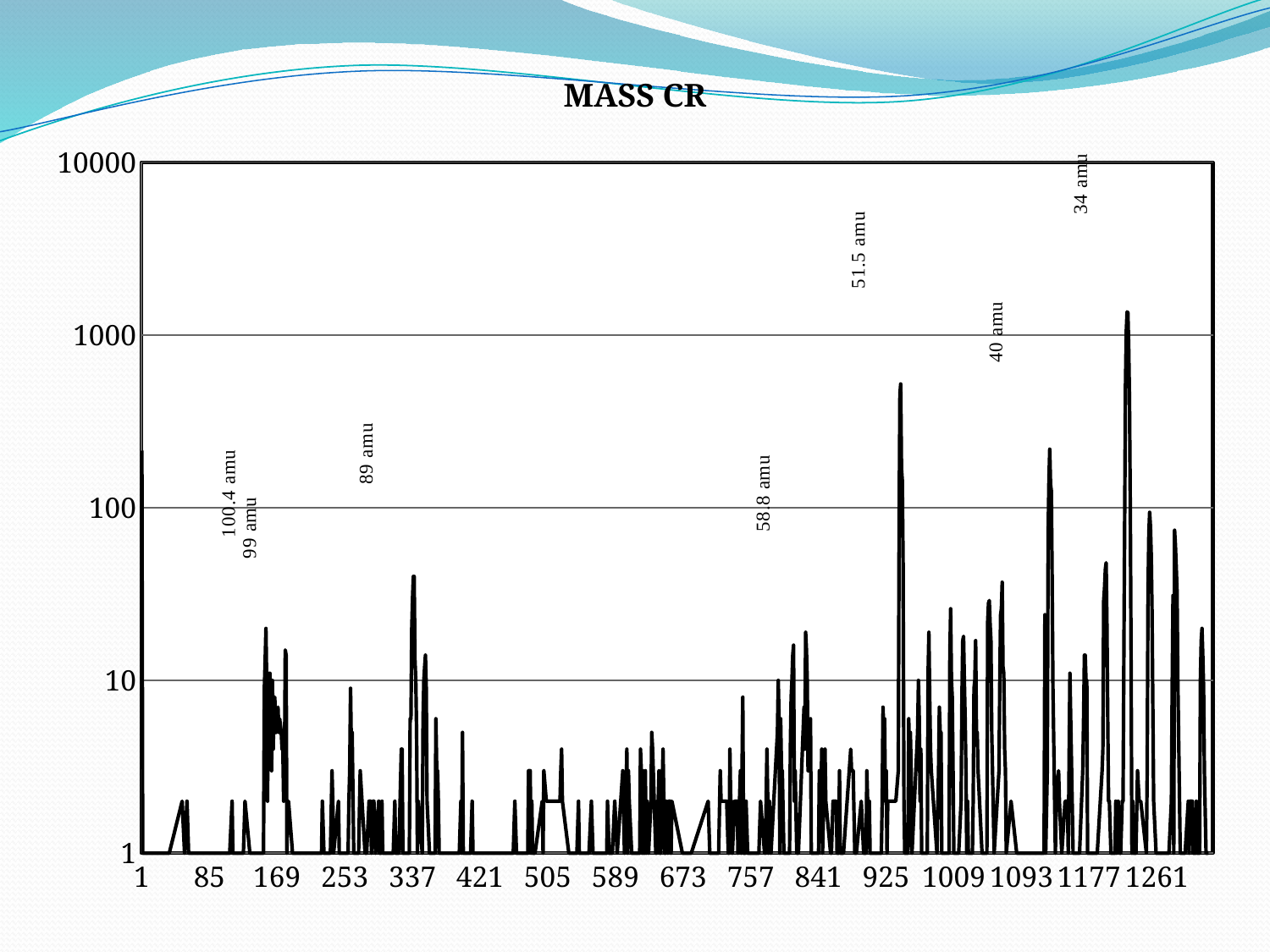
Which is larger, the peak near x = 169 or the peak near x = 1200? the peak near x = 1200 Which is larger, the peak near x = 945 or the peak near x = 1240? the peak near x = 1240 Is the value of the tallest peak (near x = 1240) greater or less than 1000? greater How many 'amu' annotations are written on the chart? 7 Which amu annotation is placed nearest the tallest peak on the right of the chart? 34 amu What is the highest value labelled on the y axis? 10000 What kind of chart is shown on the slide? line chart Is the value of the peak near x = 945 greater or less than 1000? less Is the value of the peak near x = 945 greater or less than 100? greater What is the title of the chart? MASS CR